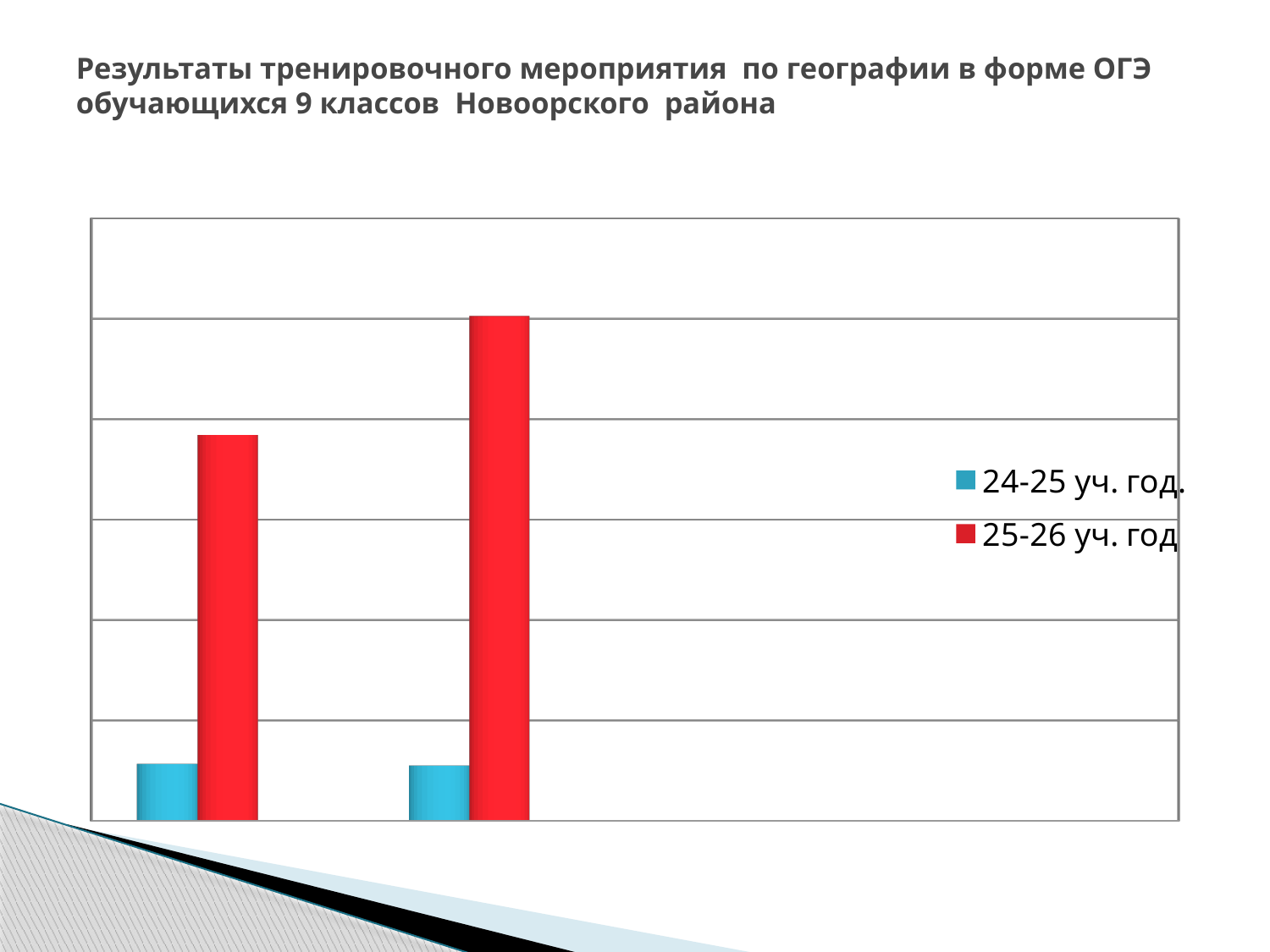
Which colour represents the 24-25 уч. год. series in the chart? blue For the 25-26 уч. год series, which group of bars has the higher value, the left or the right? right How many series does the legend list? 2 How many groups of bars are plotted in the chart? 2 Does the 25-26 уч. год series rise or fall from the left group to the right group? rises What kind of chart is shown on the slide? bar chart In the right group of bars, which series has the larger value: 24-25 уч. год. or 25-26 уч. год? 25-26 уч. год In the left group of bars, which series has the larger value: 24-25 уч. год. or 25-26 уч. год? 25-26 уч. год For the 25-26 уч. год series, which group of bars has the lower value, the left or the right? left Which colour represents the 25-26 уч. год series in the chart? red